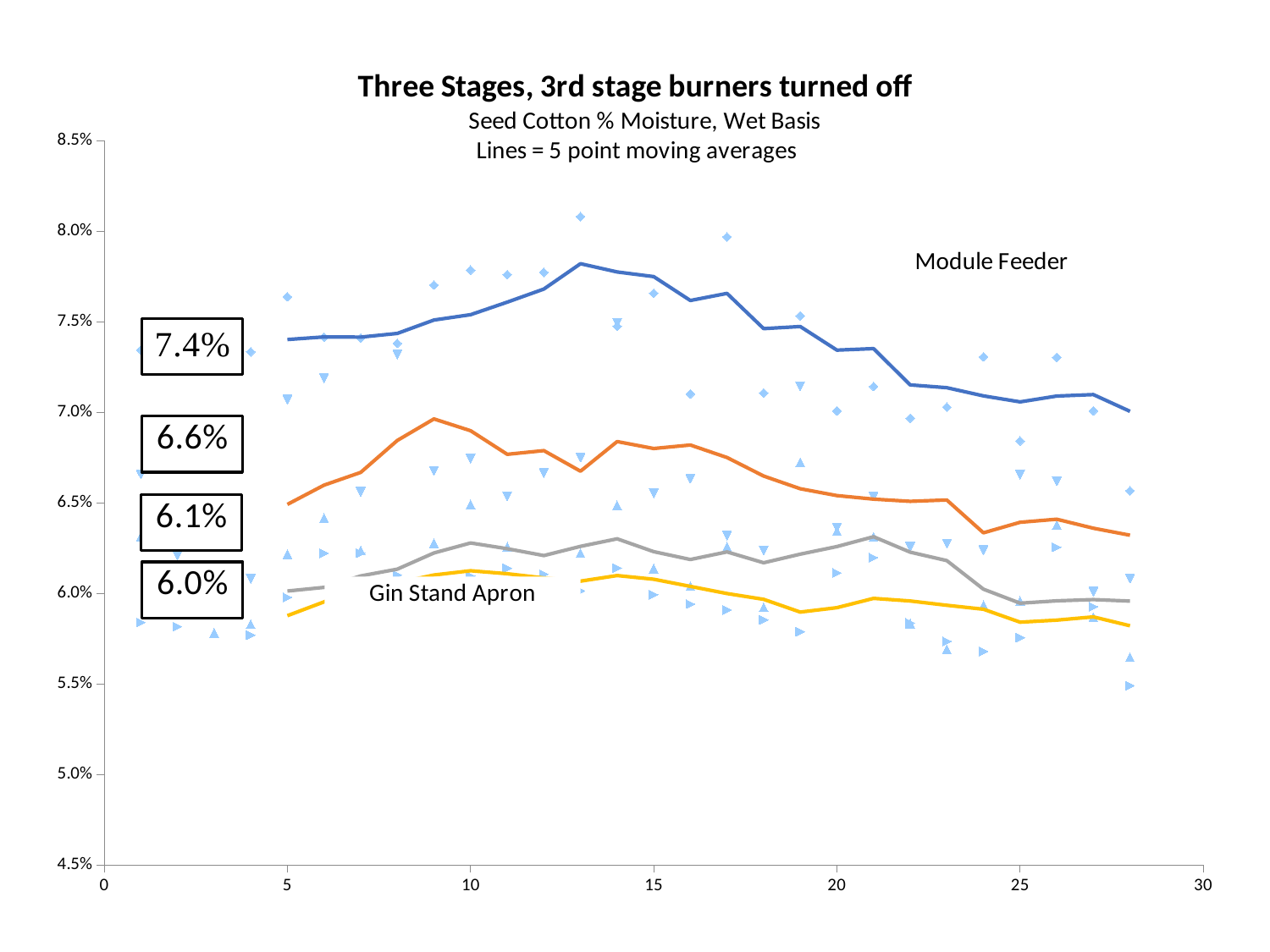
What is the highest value shown in the boxed labels on the left of the chart? 7.4% Is the Gin Stand Apron line at x = 14 greater or less than 6.5%? less According to the subtitle, what do the lines represent? 5 point moving averages What is the title of the chart? Three Stages, 3rd stage burners turned off Is the yellow line at x = 28 greater or less than 6.0%? less At x = 10, which line is higher: Module Feeder or Gin Stand Apron? Module Feeder Does the Module Feeder line rise or fall between x = 13 and x = 28? fall How many moving-average lines are plotted on the chart? 4 Is the Module Feeder line at x = 28 greater or less than 7.5%? less What kind of chart is shown on the slide? Line chart with scatter points Which labelled line is the highest on the chart? Module Feeder